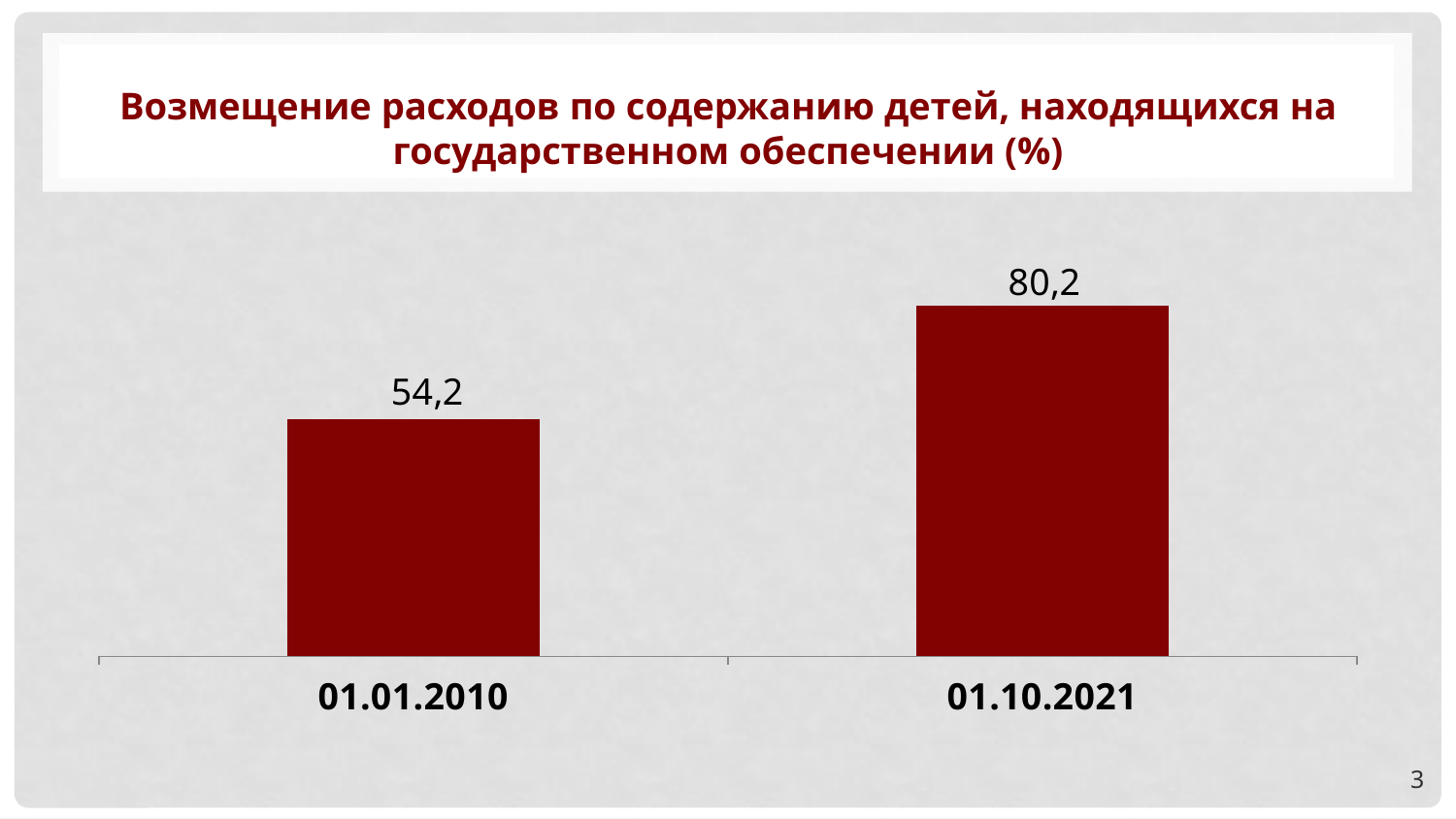
How many categories are shown on the chart? 2 What colour are the bars on the chart? dark red What is the title of the chart? Возмещение расходов по содержанию детей, находящихся на государственном обеспечении (%) Which category has the lowest value? 01.01.2010 Do the values rise or fall from 01.01.2010 to 01.10.2021? rise Which is larger, the value for 01.01.2010 or the value for 01.10.2021? 01.10.2021 What kind of chart is shown on the slide? bar chart What is the value for 01.10.2021? 80,2 What is the value for 01.01.2010? 54,2 What is the difference between the values for 01.10.2021 and 01.01.2010? 26 Which category has the highest value? 01.10.2021